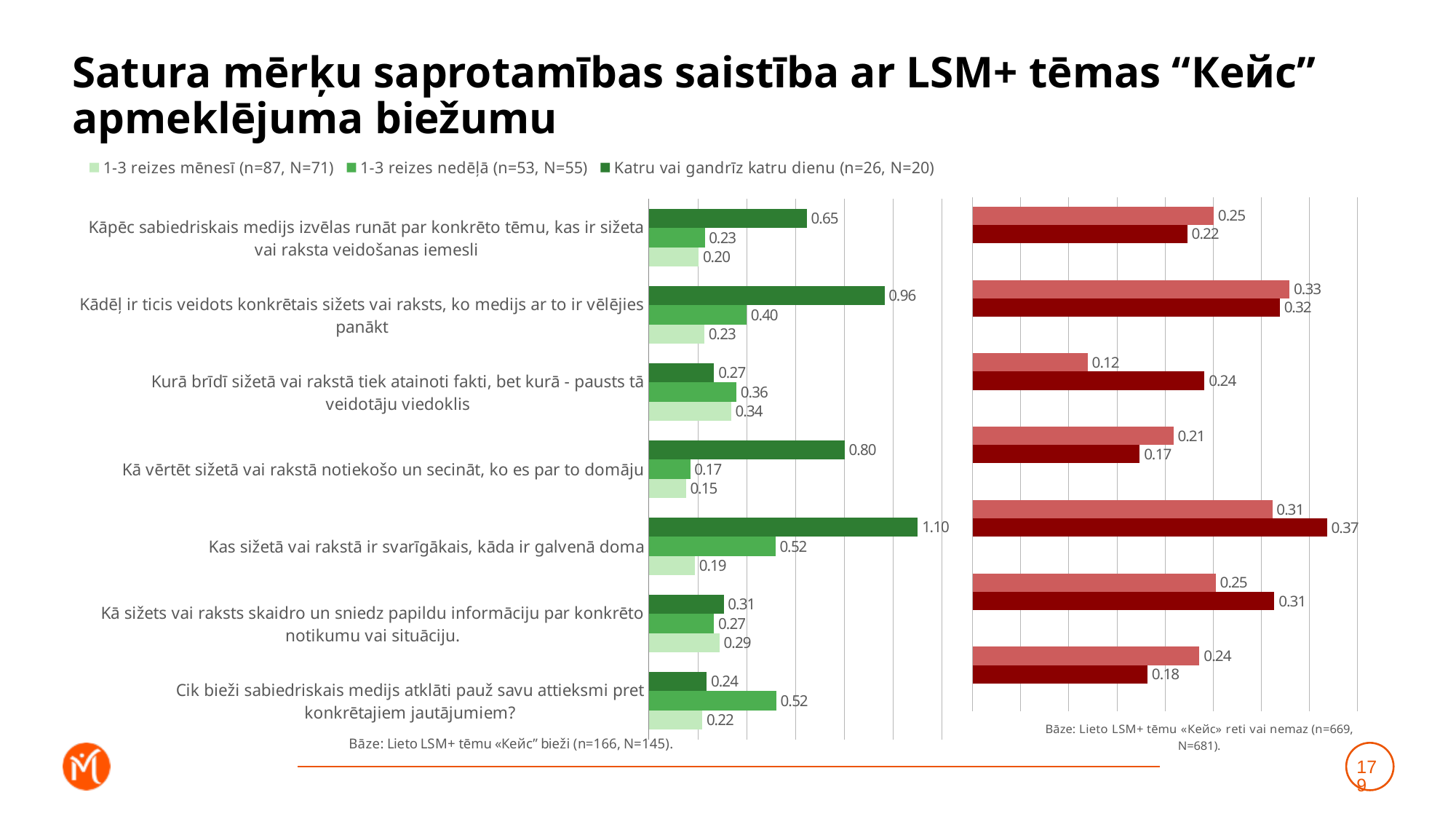
In the left chart, what is the value for 'Katru vai gandrīz katru dienu' for the category 'Kas sižetā vai rakstā ir svarīgākais, kāda ir galvenā doma'? 1.10 In the left chart, for the category 'Kādēļ ir ticis veidots konkrētais sižets vai raksts, ko medijs ar to ir vēlējies panākt', what is the difference between the 'Katru vai gandrīz katru dienu' value and the '1-3 reizes mēnesī' value? 0.73 What type of chart is the left chart on the slide? bar chart In the left chart, which category has the highest value for 'Katru vai gandrīz katru dienu'? Kas sižetā vai rakstā ir svarīgākais, kāda ir galvenā doma In the right (red) chart, what is the highest value labelled on any bar? 0.37 How many categories (questions) are plotted in the left chart? 7 In the left chart, for the category 'Cik bieži sabiedriskais medijs atklāti pauž savu attieksmi pret konkrētajiem jautājumiem?', which series has the larger value: '1-3 reizes nedēļā' or 'Katru vai gandrīz katru dienu'? 1-3 reizes nedēļā In the left chart, what is the value for '1-3 reizes nedēļā' for the category 'Kādēļ ir ticis veidots konkrētais sižets vai raksts, ko medijs ar to ir vēlējies panākt'? 0.40 In the left chart, what is the value for '1-3 reizes mēnesī' for the category 'Kurā brīdī sižetā vai rakstā tiek atainoti fakti, bet kurā - pausts tā veidotāju viedoklis'? 0.34 In the left chart, which category has the lowest value for '1-3 reizes mēnesī'? Kā vērtēt sižetā vai rakstā notiekošo un secināt, ko es par to domāju In the left chart's legend, which colour represents 'Katru vai gandrīz katru dienu'? dark green How many series does the legend of the left chart list? 3